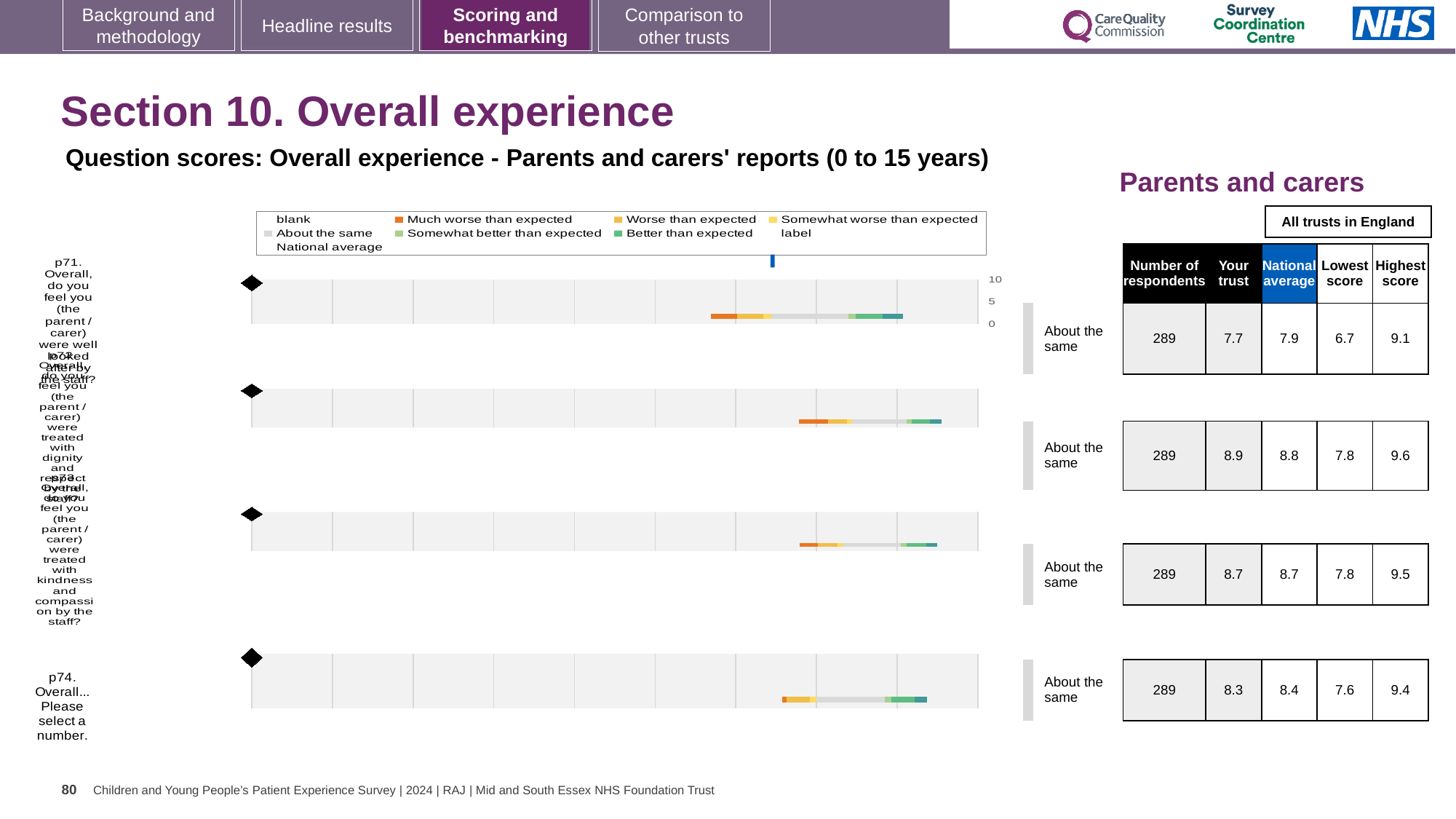
What is the 'Your trust' score for question p71 (Overall, do you feel you were well looked after by the staff?)? 7.7 What benchmark category is shown next to the bar for question p74? About the same What is the highest 'Your trust' score shown across the four Overall experience questions? 8.9 What kind of chart is used to show the question scores for Overall experience? bar chart What is the lowest 'Your trust' score shown across the four Overall experience questions? 7.7 How many questions (bars) are plotted in the Overall experience chart? 4 For question p71, what is the difference between the highest score (9.1) and the lowest score (6.7) among all trusts? 2.4 For question p71, which is larger: the 'Your trust' score or the national average? National average How many respondents answered question p74? 289 What is the national average score for question p71? 7.9 What is the highest score among all trusts in England for question p74 (Overall... Please select a number)? 9.4